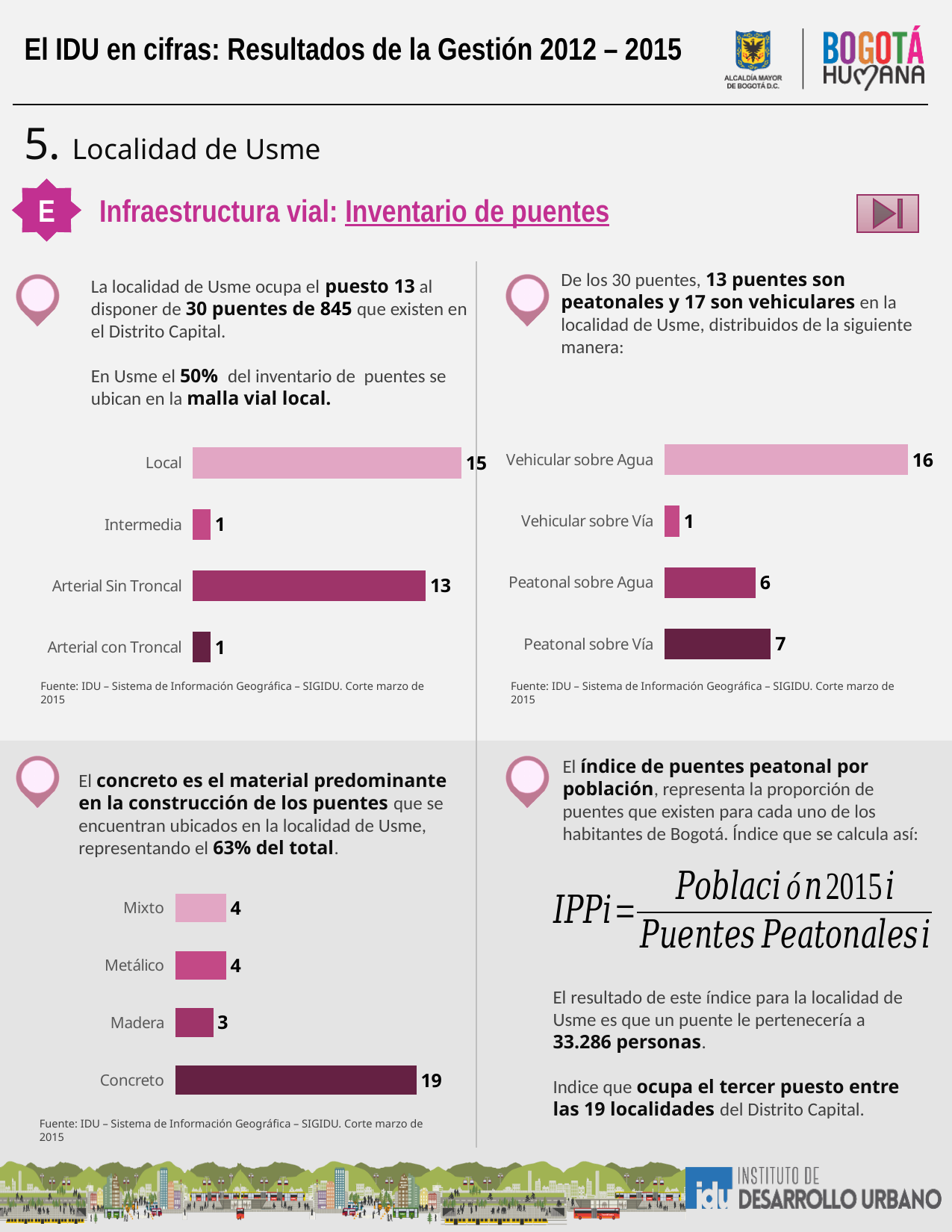
In the bottom-left chart, what is the difference between Concreto and Madera? 16 In the top-right chart, which category has the lowest value? Vehicular sobre Vía In the top-left chart, what is the difference between Local and Arterial Sin Troncal? 2 In the bottom-left chart, what is the value for Concreto? 19 In the top-left chart, what is the value for Local? 15 In the bottom-left chart, which category has the lowest value? Madera In the top-left chart, which category has the highest value? Local In the top-right chart, what is the difference between Vehicular sobre Agua and Peatonal sobre Vía? 9 What type of chart is the bottom-left chart? Bar chart How many categories does the top-left chart show? 4 In the top-right chart, what is the value for Peatonal sobre Agua? 6 In the top-right chart, which is larger, Peatonal sobre Vía or Peatonal sobre Agua? Peatonal sobre Vía